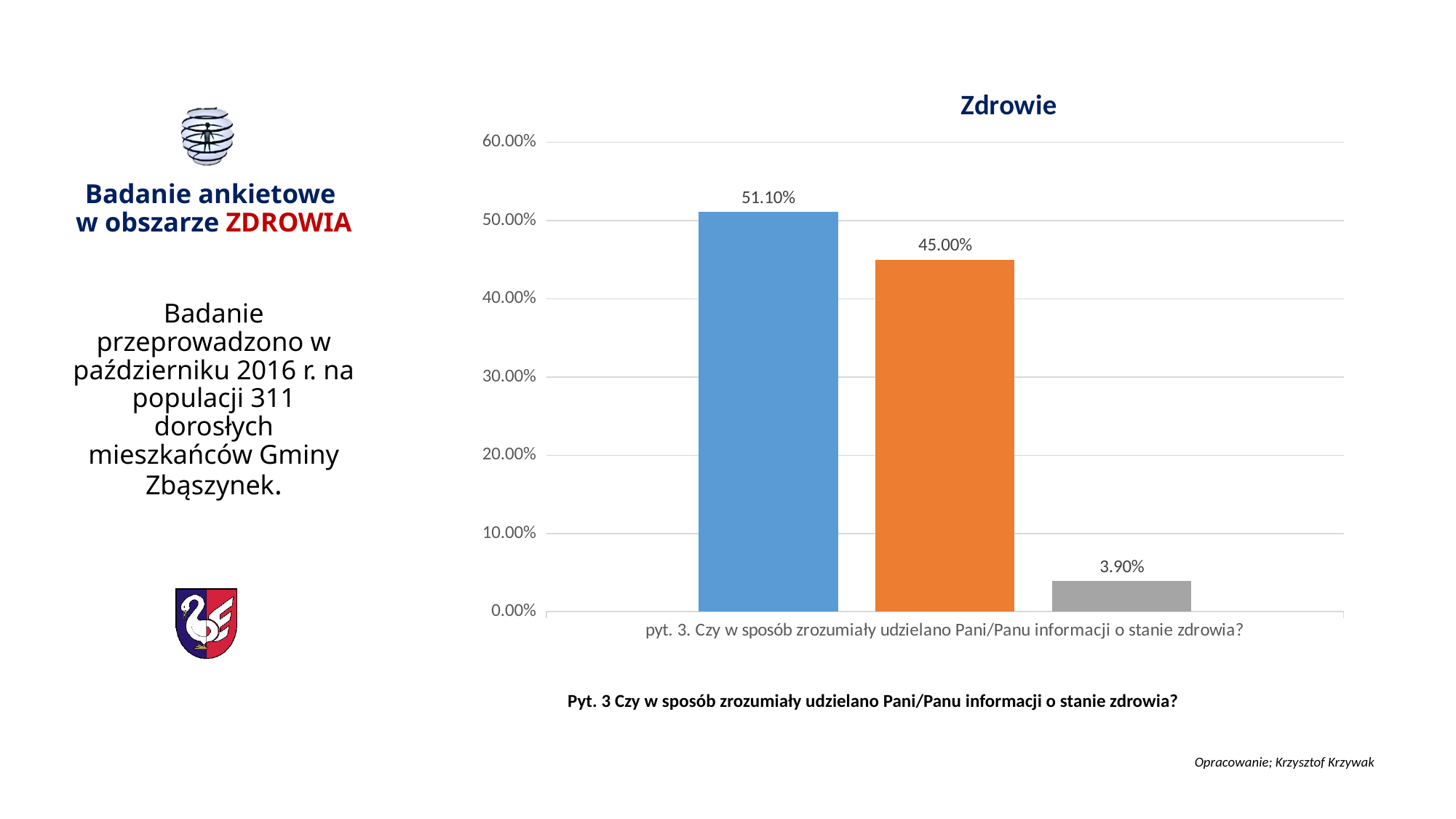
What value is shown on the blue bar? 51.10% Which bar has the highest value? the blue bar (51.10%) Is the value of the orange bar greater or less than 50.00%? less What value is shown on the grey bar? 3.90% Which bar has the lowest value? the grey bar (3.90%) How many bars are plotted in the chart? 3 What kind of chart is shown on the slide? bar chart Which is larger, the orange bar or the grey bar? the orange bar What is the title of the chart? Zdrowie What value is shown on the orange bar? 45.00% Do the bar values rise or fall from left to right? fall What is the difference between the blue bar and the orange bar? 6.10%